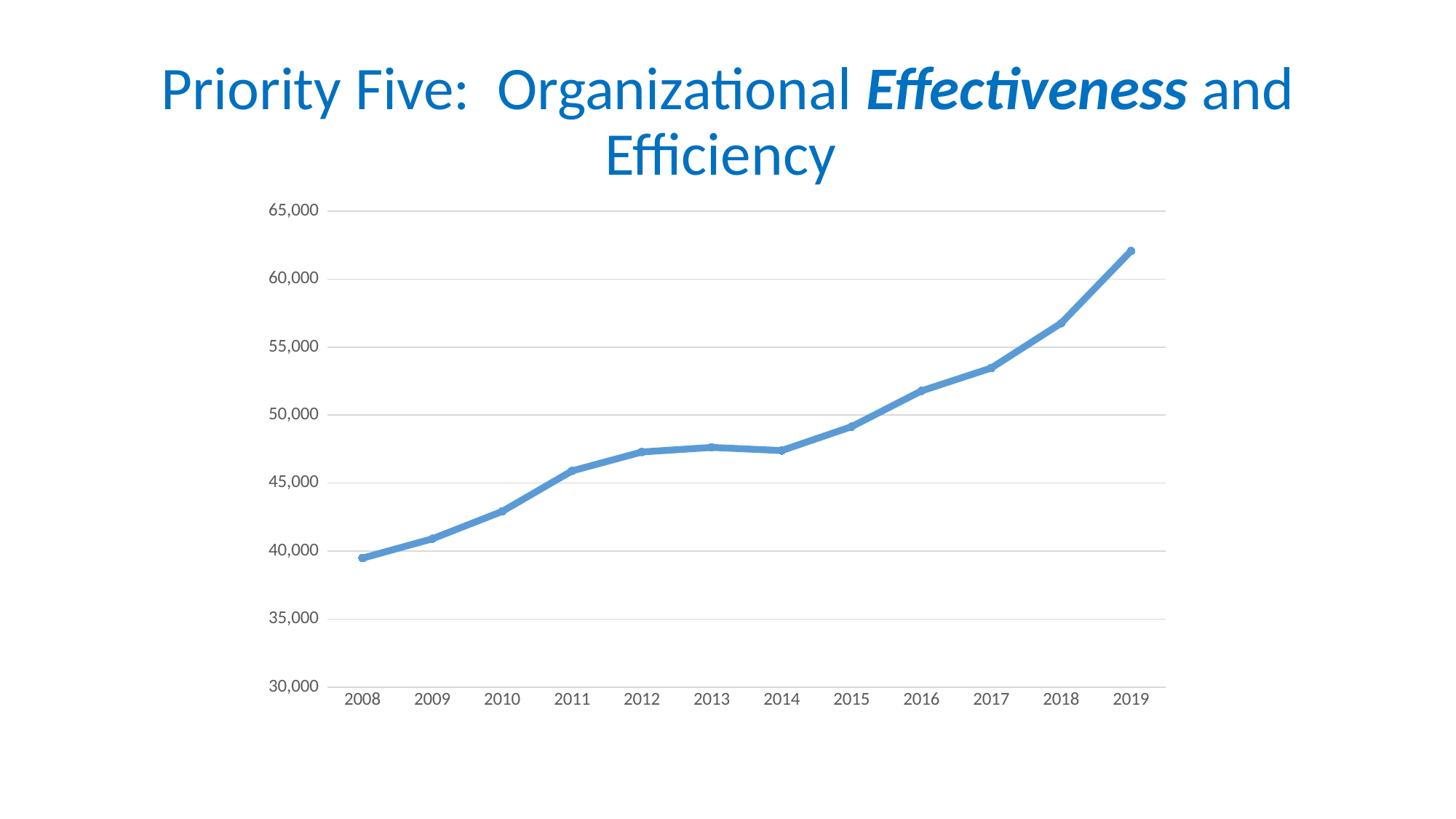
What is the title of the slide containing the chart? Priority Five: Organizational Effectiveness and Efficiency Is the value for 2008 greater or less than 40,000? less Which year has the highest value? 2019 Which is larger, the value for 2016 or the value for 2012? 2016 How many years are plotted along the x axis? 12 Is the value for 2018 greater or less than 55,000? greater Is the value for 2010 greater or less than 45,000? less Which year has the lowest value? 2008 What kind of chart is shown on the slide? line chart Do the values generally rise or fall from 2008 to 2019? rise